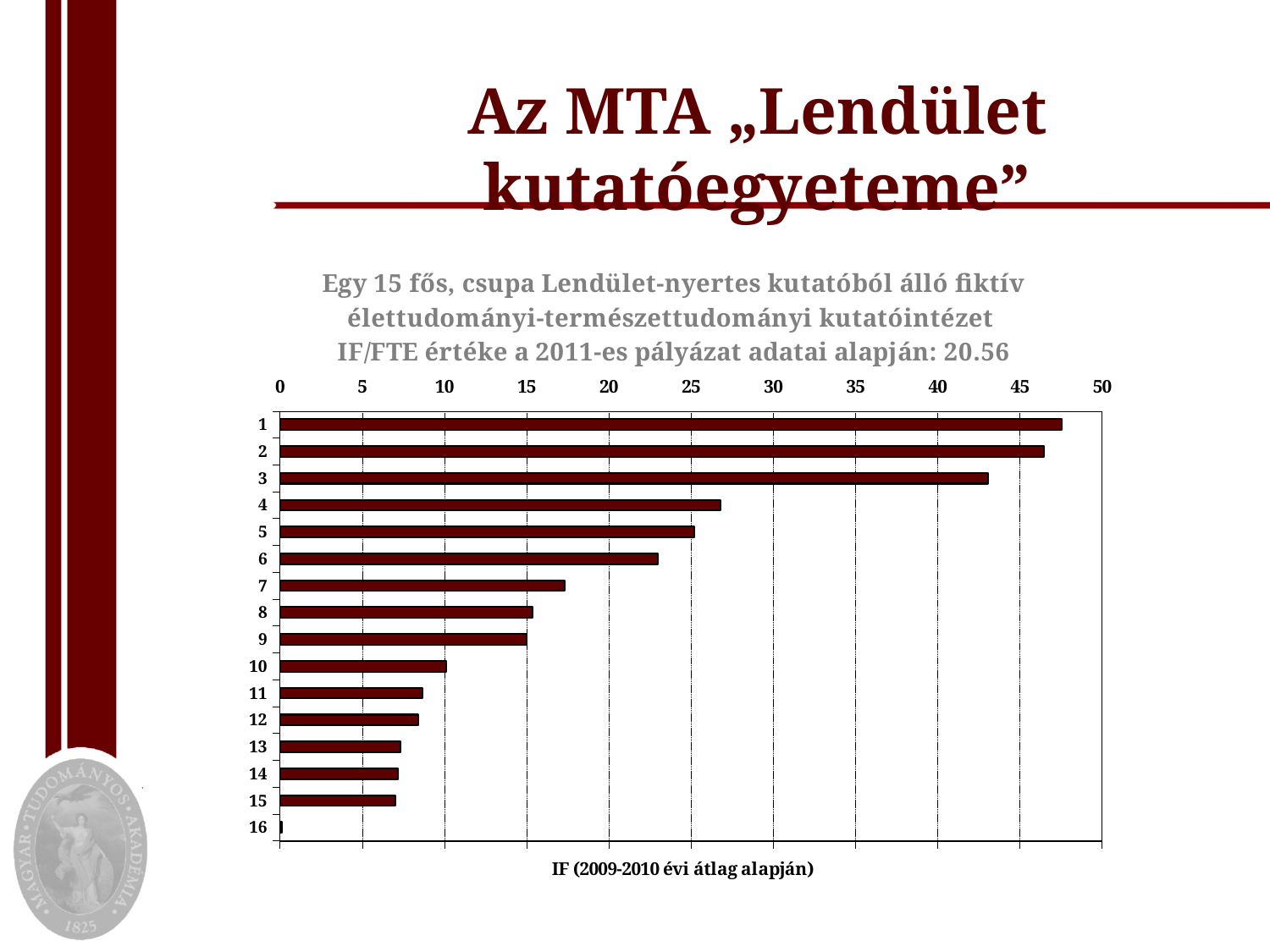
How many categories (bars) does the chart show? 16 Is the value for category 10 greater or less than 15? less Is the value for category 4 greater or less than 30? less Do the bar values rise or fall as the category number increases from 1 to 16? fall Is the value for category 7 greater or less than 15? greater What is the axis title shown below the chart? IF (2009-2010 évi átlag alapján) Which category has the highest value in the chart? 1 Which has the larger value, category 2 or category 5? category 2 What kind of chart is shown on the slide? bar chart Which category has the lowest value in the chart? 16